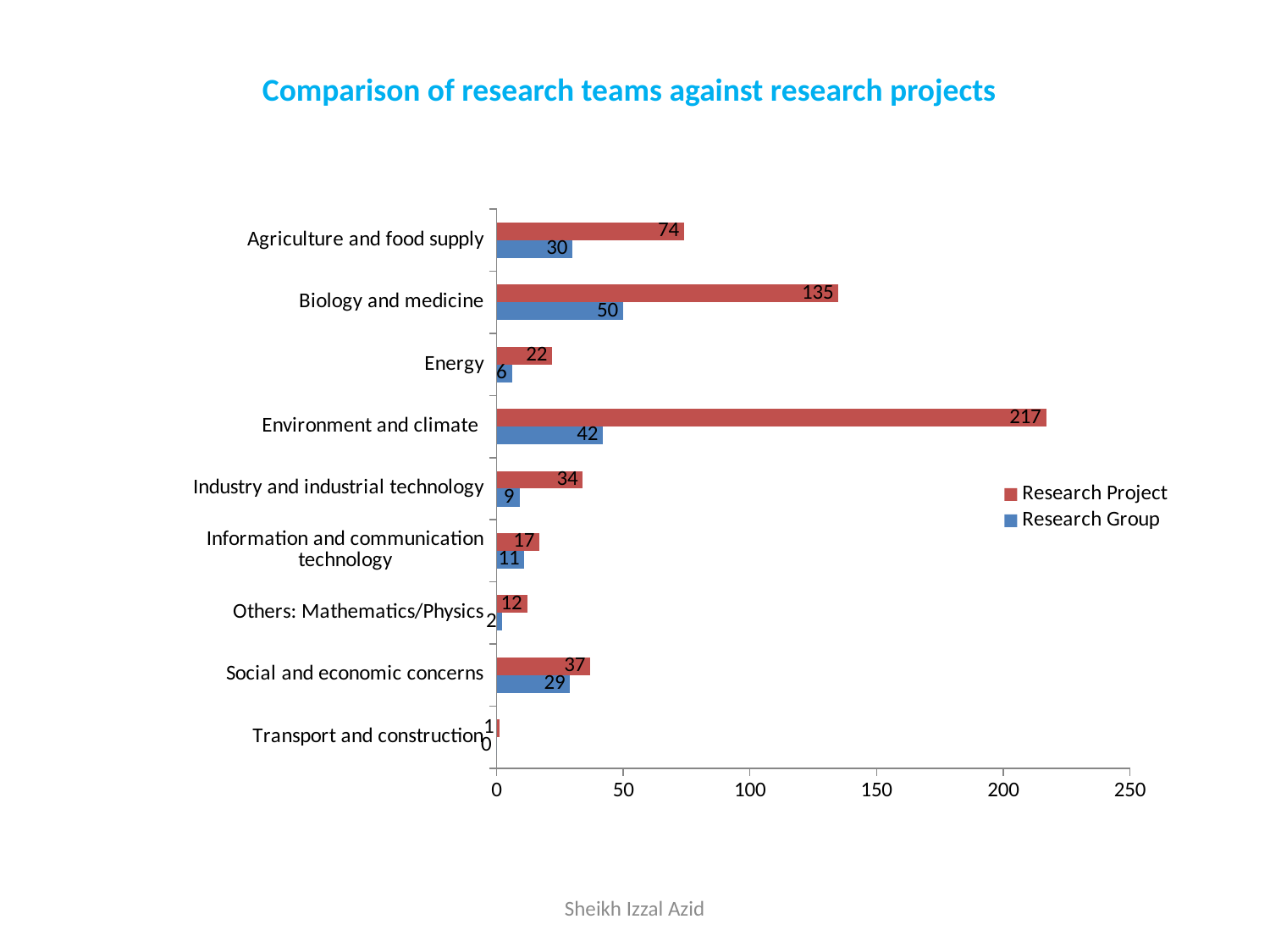
What kind of chart is shown on the slide? Bar chart What is the Research Project value for Environment and climate? 217 Which category has the highest Research Project value? Environment and climate Which colour represents the Research Group series? Blue What is the title of the chart? Comparison of research teams against research projects Which is larger: the Research Project value for Biology and medicine or the Research Project value for Agriculture and food supply? Biology and medicine How many series does the legend list? 2 What is the difference between the Research Project and Research Group values for Agriculture and food supply? 44 Which category has the lowest Research Group value? Transport and construction What is the Research Group value for Social and economic concerns? 29 How many categories are shown on the chart? 9 What is the Research Group value for Biology and medicine? 50